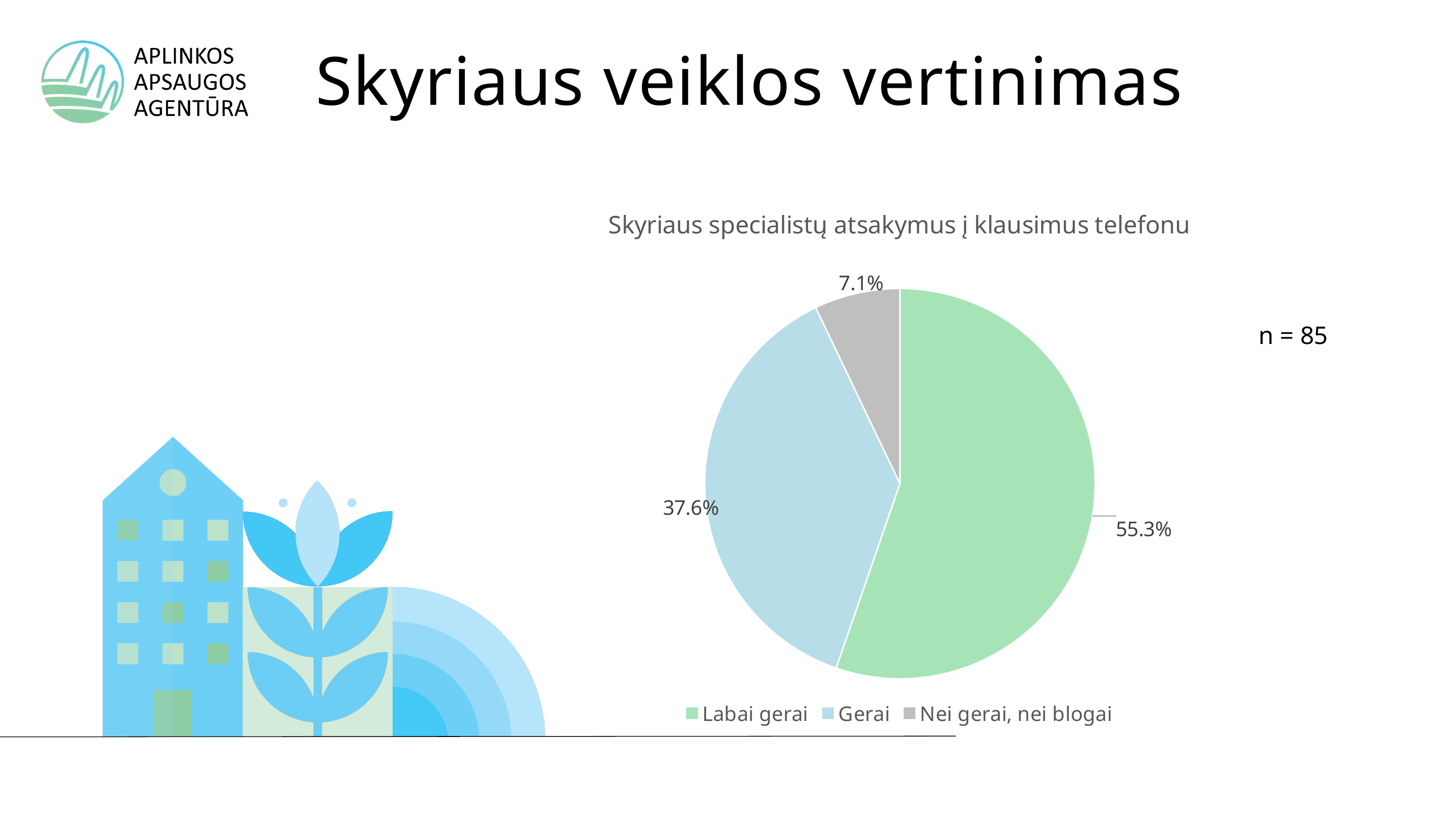
What share of the pie does "Gerai" have? 37.6% What kind of chart is shown on the slide? pie chart What sample size (n) is stated next to the chart? n = 85 What is the difference in percentage points between "Labai gerai" and "Gerai"? 17.7 What share of the pie does "Nei gerai, nei blogai" have? 7.1% Which is larger, the share for "Gerai" or the share for "Nei gerai, nei blogai"? Gerai What share of the pie does "Labai gerai" have? 55.3% How many categories does the pie chart show? 3 What is the title of the pie chart? Skyriaus specialistų atsakymus į klausimus telefonu Which category has the largest slice of the pie? Labai gerai What is the difference in percentage points between "Gerai" and "Nei gerai, nei blogai"? 30.5 Which category has the smallest slice of the pie? Nei gerai, nei blogai